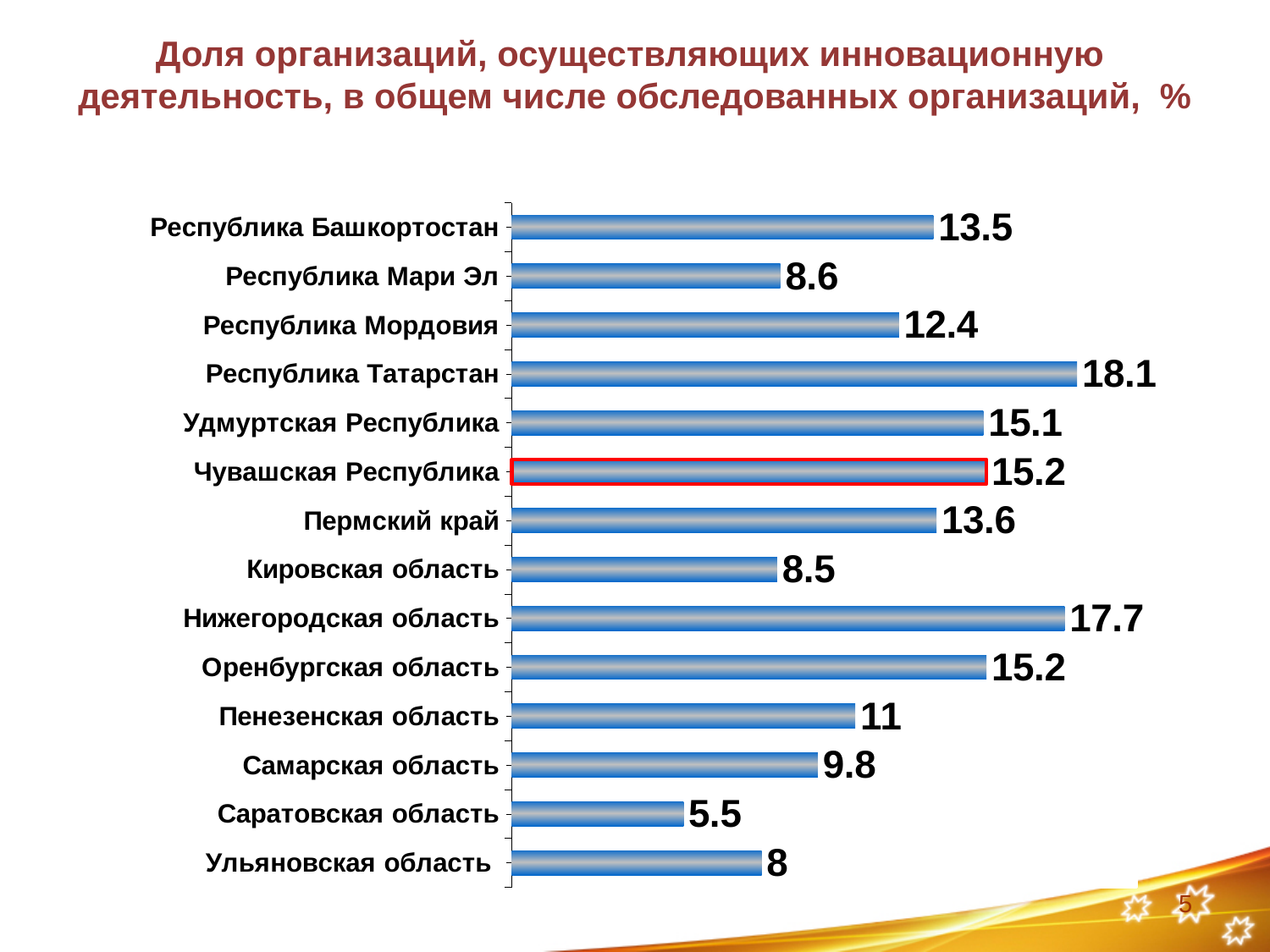
What is the difference between the values for Пермский край and Кировская область? 5.1 Which region's bar is outlined with a red rectangle? Чувашская Республика Which region has the lowest value? Саратовская область What kind of chart is shown on the slide? Bar chart What is the value for Республика Татарстан? 18.1 What is the value for Ульяновская область? 8 How many regions are shown in the chart? 14 What is the difference between the values for Республика Татарстан and Нижегородская область? 0.4 What is the value for Саратовская область? 5.5 What is the value for Чувашская Республика? 15.2 Which is larger, the value for Республика Башкортостан or the value for Республика Мордовия? Республика Башкортостан Which region has the highest value? Республика Татарстан